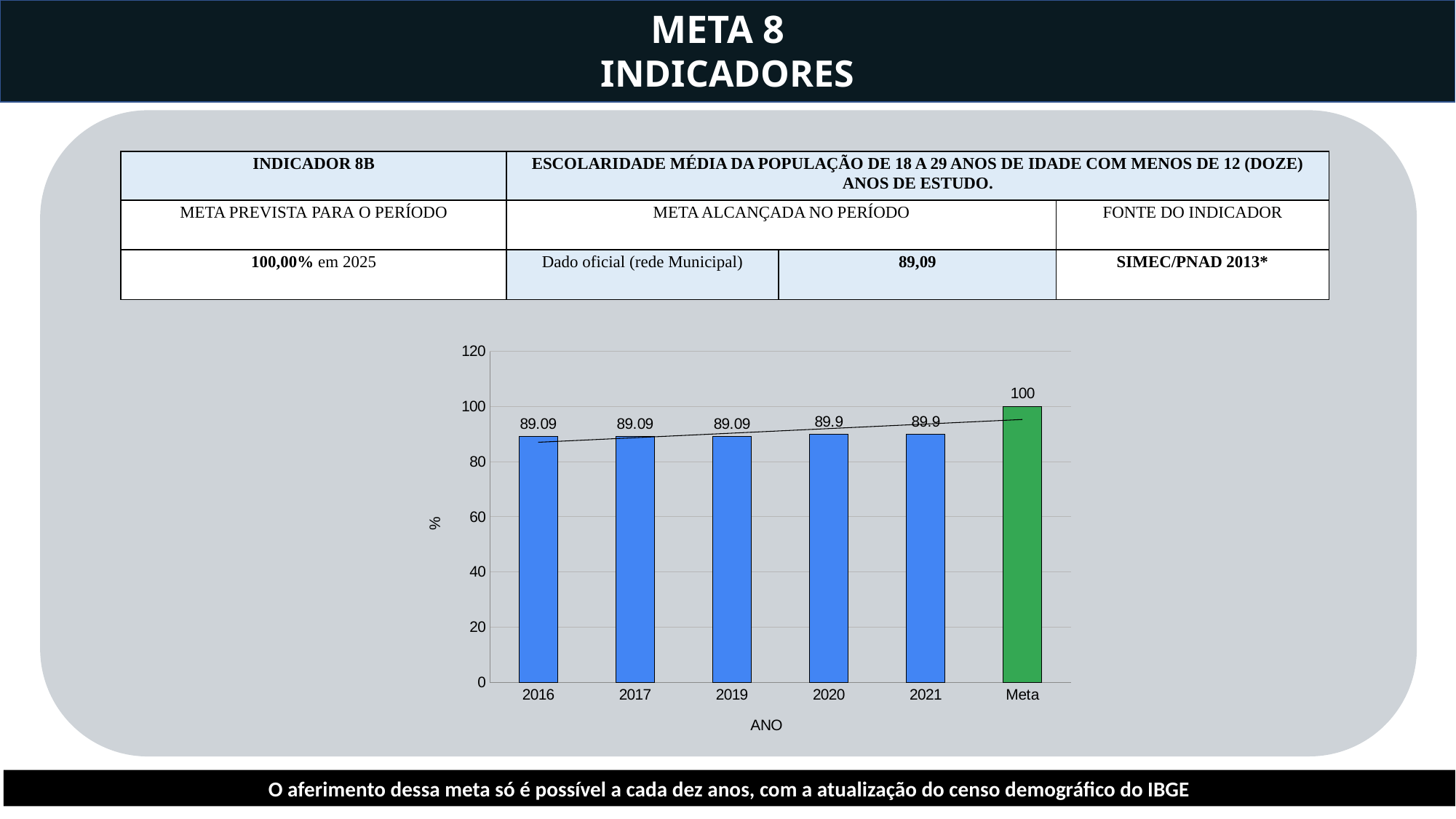
What is the difference between the Meta value and the 2021 value? 10.1 What kind of chart is shown on the slide? bar chart What is the label of the x axis? ANO Is the value for 2017 greater or less than 80? greater What is the value for Meta? 100 Which category has the highest value? Meta What is the value for 2020? 89.9 What is the difference between the 2020 value and the 2017 value? 0.81 What is the value for 2016? 89.09 How many bars are shown in the chart? 6 What colour is the Meta bar? green Which is larger, the value for 2019 or the value for Meta? Meta